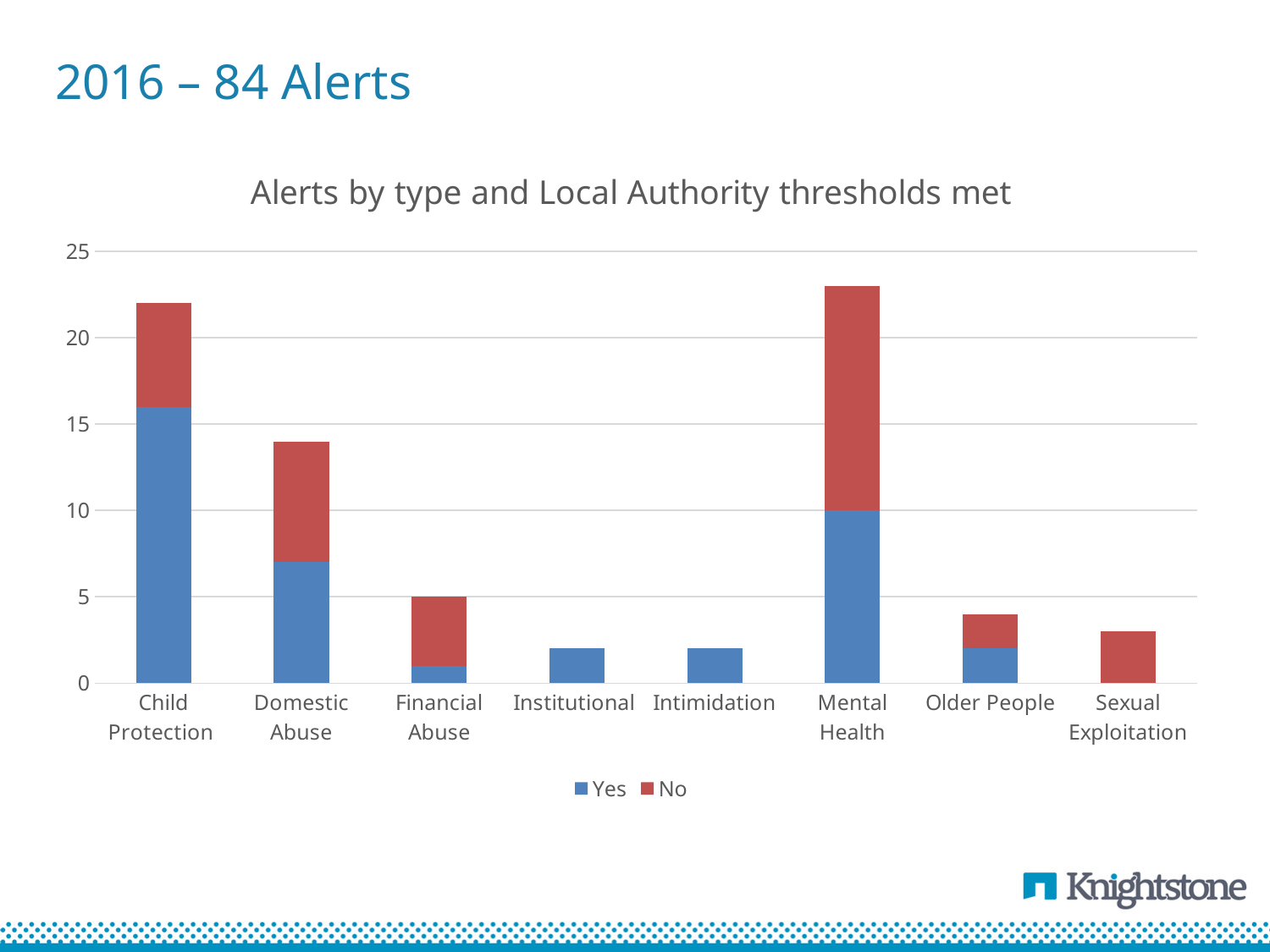
How many series does the legend list? 2 Is the total bar height for Older People greater or less than 5? less Which category has the largest 'No' segment? Mental Health Is the total bar height for Child Protection greater or less than 20? greater How many alert types (categories) are shown on the x axis? 8 What kind of chart is shown on the slide? Stacked bar chart What is the title of the chart? Alerts by type and Local Authority thresholds met Is the total bar height for Domestic Abuse greater or less than 10? greater What are the two legend entries of the chart? Yes and No Which is larger: the 'Yes' value for Child Protection or the 'Yes' value for Mental Health? Child Protection Which is larger: the total bar for Domestic Abuse or the total bar for Financial Abuse? Domestic Abuse Which category has the largest 'Yes' segment? Child Protection